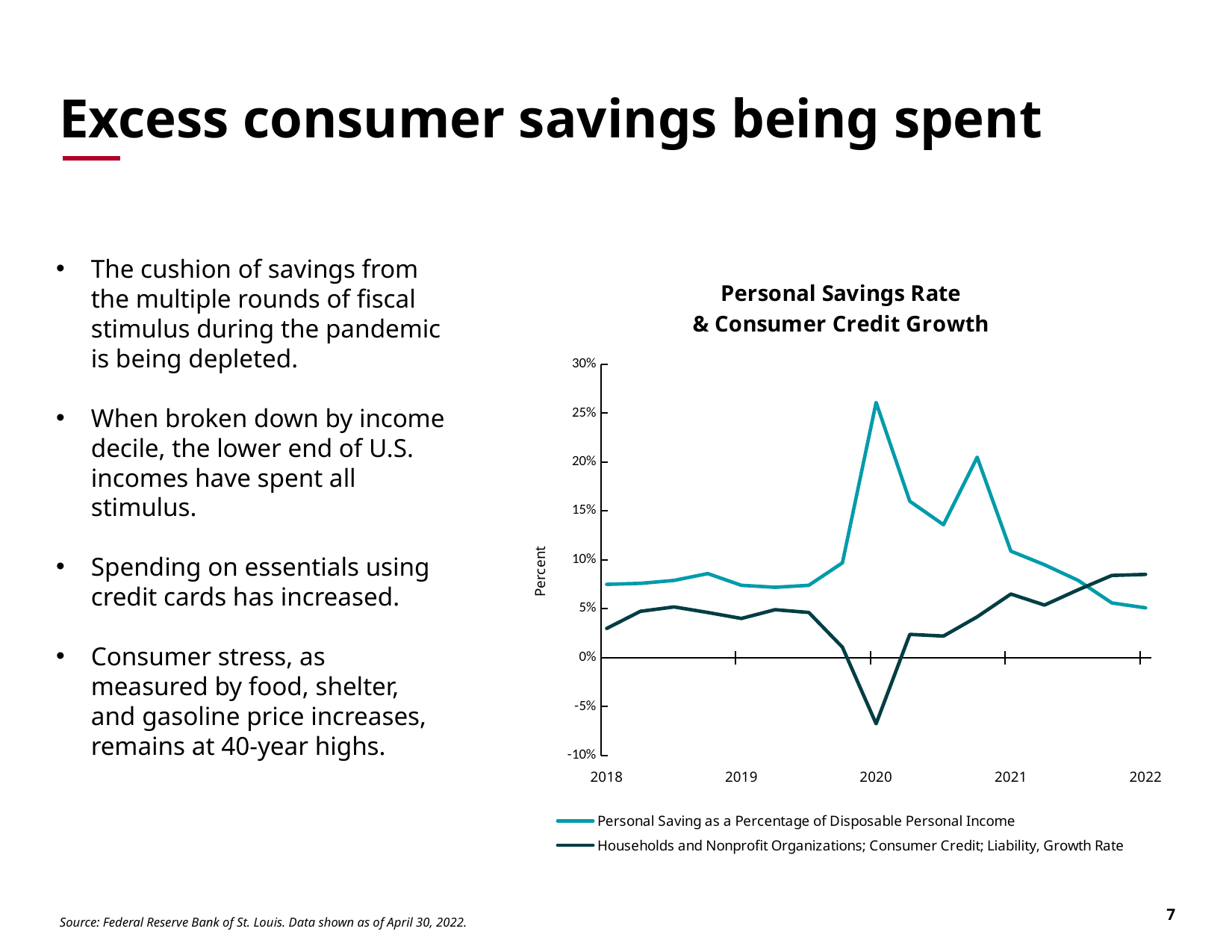
At 2018, which series is higher: Personal Saving as a Percentage of Disposable Personal Income or the consumer credit growth rate? Personal Saving as a Percentage of Disposable Personal Income What kind of chart is shown on the slide? line chart In which year does the Households and Nonprofit Organizations consumer credit growth rate line reach its lowest point? 2020 At 2022, which series is higher: Personal Saving as a Percentage of Disposable Personal Income or the consumer credit growth rate? consumer credit growth rate What is the title of the chart? Personal Savings Rate & Consumer Credit Growth In which year does the Personal Saving as a Percentage of Disposable Personal Income line reach its highest point? 2020 Does the consumer credit growth rate line rise or fall between 2020 and 2022? rise Is the value of Personal Saving as a Percentage of Disposable Personal Income at the start of 2018 greater or less than 5%? greater How many series does the chart's legend list? 2 Is the peak value of Personal Saving as a Percentage of Disposable Personal Income in 2020 greater or less than 20%? greater What is the label on the chart's vertical axis? Percent Is the lowest value of the consumer credit growth rate line in 2020 greater or less than -5%? less